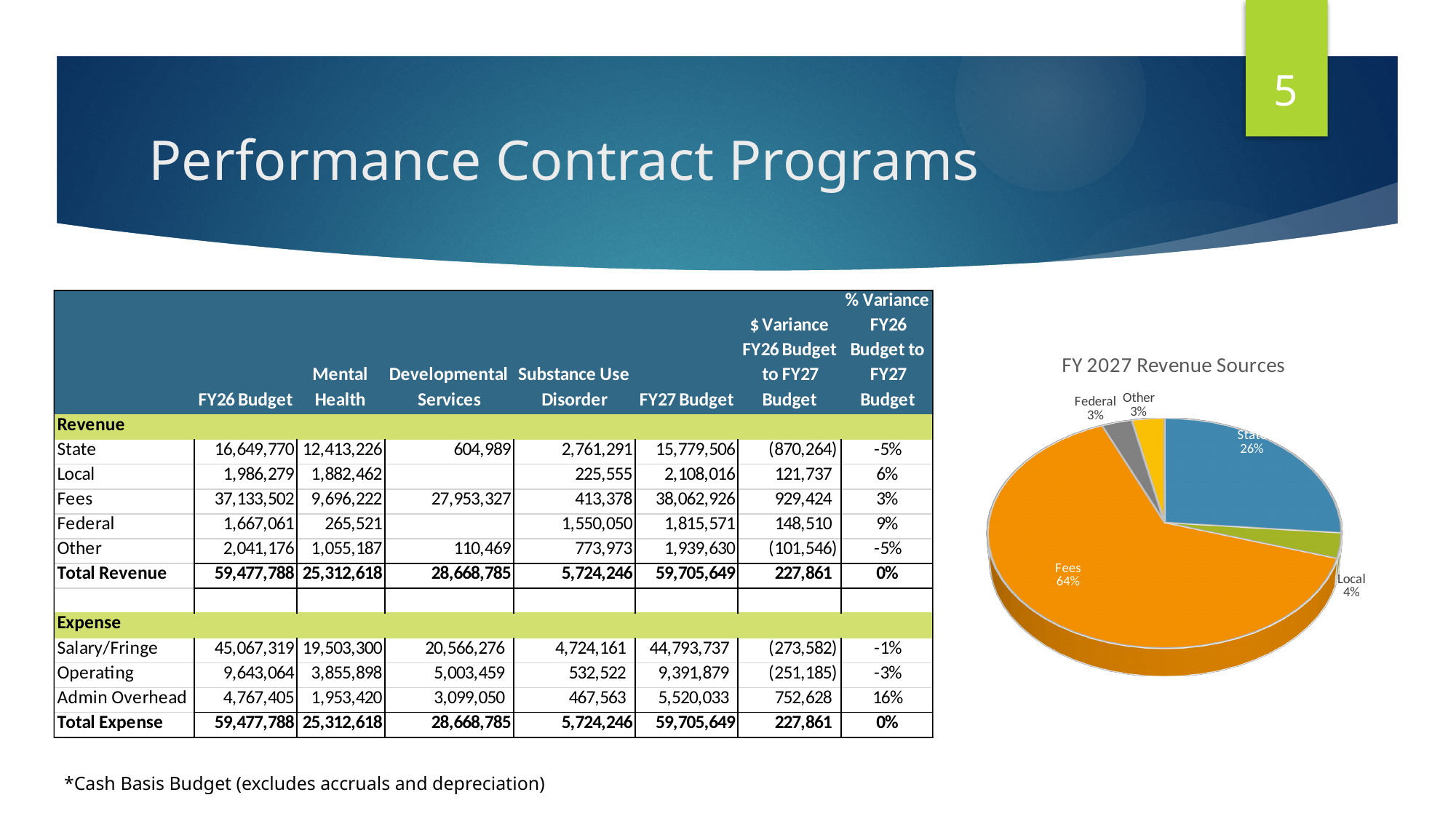
What kind of chart is shown on the slide? pie chart Which revenue source has the largest slice in the FY 2027 Revenue Sources pie chart? Fees In the FY 2027 Revenue Sources pie chart, what is the combined share of Federal and Other? 6% What share of FY 2027 revenue sources does State represent in the pie chart? 26% What colour is the Fees slice in the FY 2027 Revenue Sources pie chart? orange In the FY 2027 Revenue Sources pie chart, which slice is larger, State or Local? State What share of FY 2027 revenue sources does Federal represent in the pie chart? 3% What share of FY 2027 revenue sources does Fees represent in the pie chart? 64% What is the title of the pie chart? FY 2027 Revenue Sources In the FY 2027 Revenue Sources pie chart, how many percentage points larger is the Fees share than the State share? 38 How many slices does the FY 2027 Revenue Sources pie chart have? 5